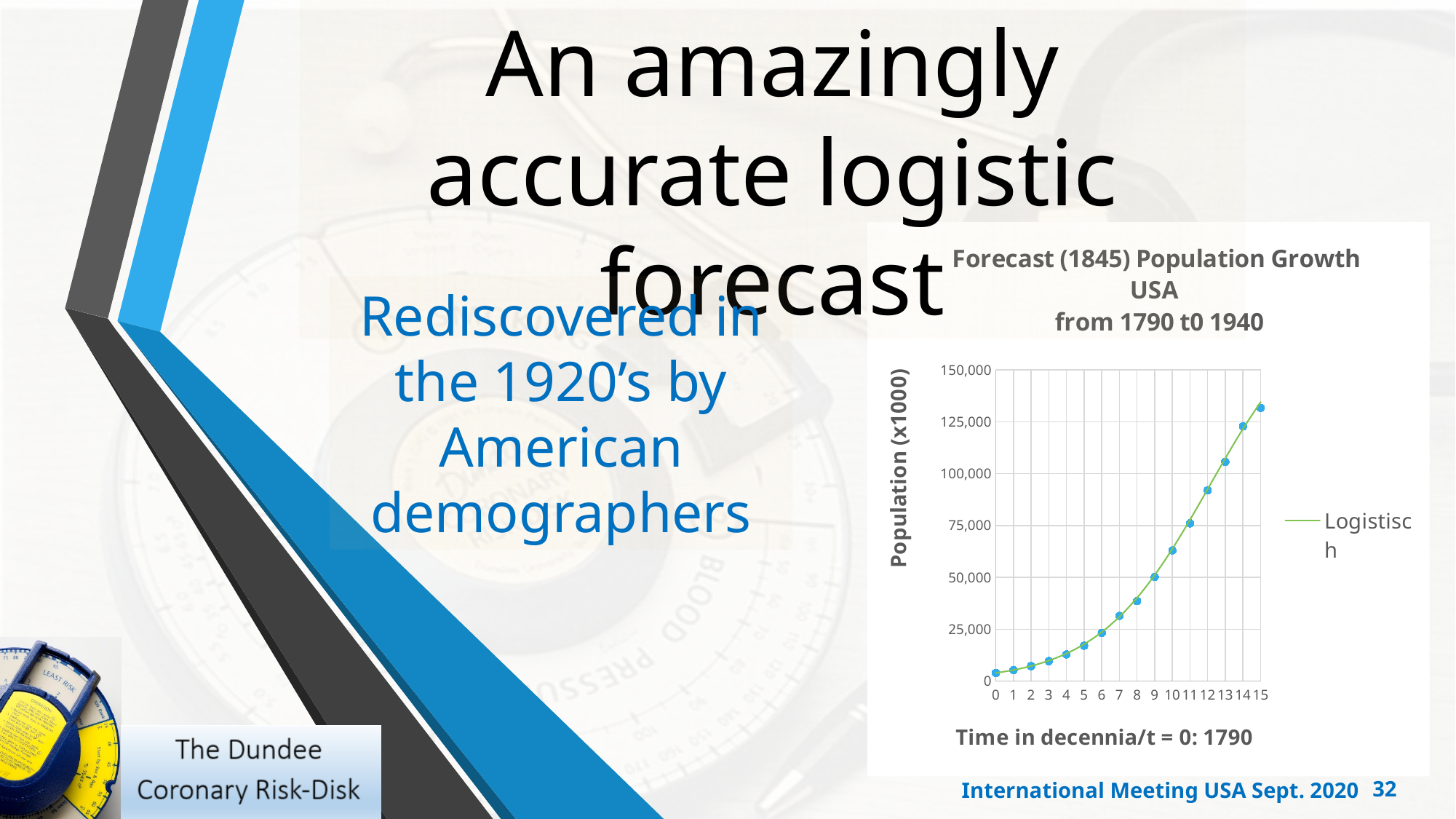
Is the population value at t = 15 greater or less than 125,000? greater At which value of t is the plotted population highest? 15 What is the name of the series shown in the chart legend? Logistisch What kind of chart is shown on the slide? line chart Is the population value at t = 5 greater or less than 25,000? less Do the population values rise or fall as time increases along the x axis? rise How many series does the chart legend list? 1 How many data points are plotted on the chart (t = 0 to 15)? 16 At which value of t is the plotted population lowest? 0 Which has the larger population value, t = 8 or t = 13? t = 13 Is the population value at t = 12 greater or less than 100,000? less What is the label of the y axis of the chart? Population (x1000)